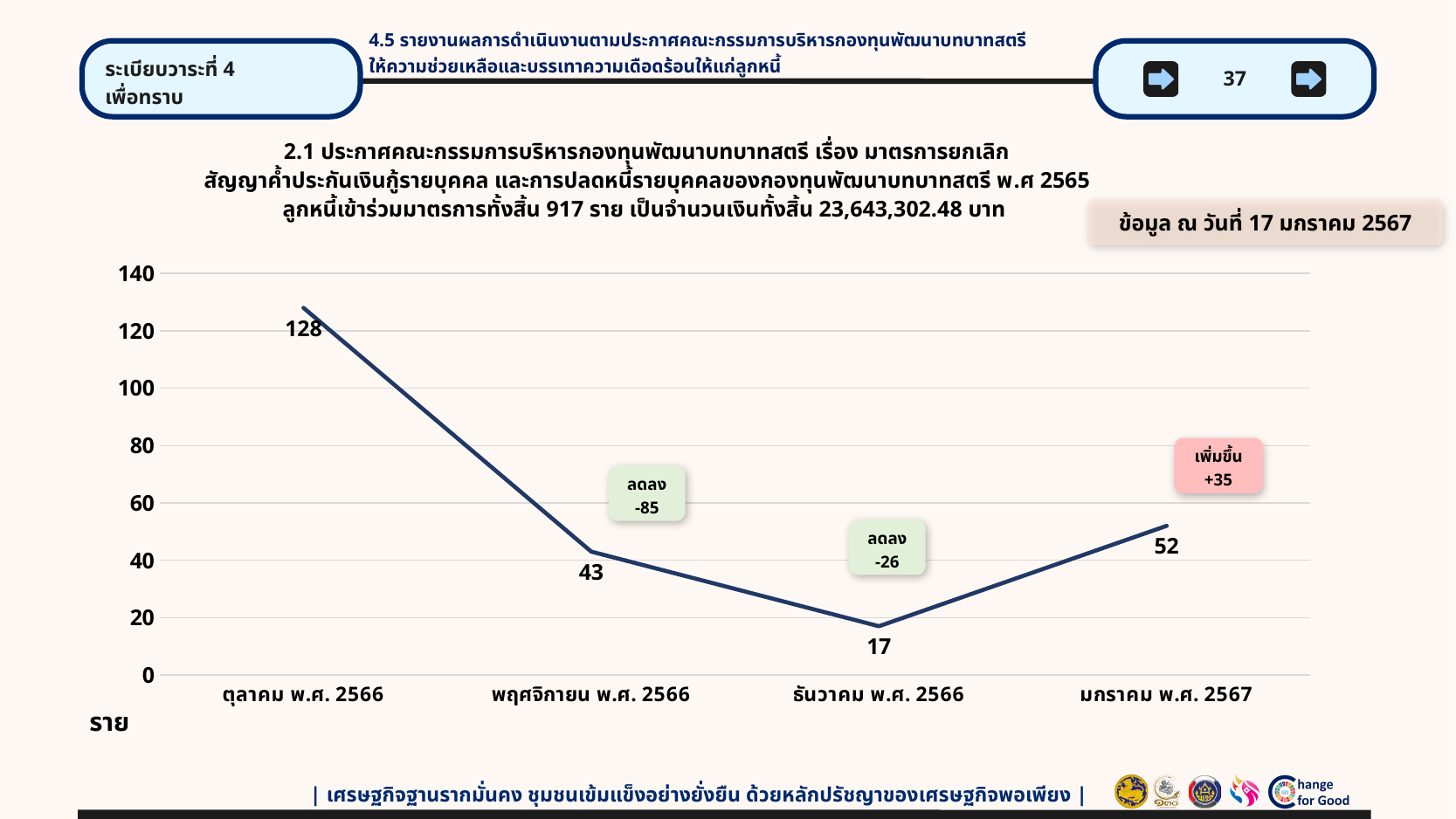
Which month has the highest value? ตุลาคม พ.ศ. 2566 What is the difference between the values for มกราคม พ.ศ. 2567 and ธันวาคม พ.ศ. 2566? 35 How many months are plotted on the chart? 4 What is the value for ธันวาคม พ.ศ. 2566? 17 Which month has the lowest value? ธันวาคม พ.ศ. 2566 Is the value for ตุลาคม พ.ศ. 2566 greater or less than 100? greater What is the value for ตุลาคม พ.ศ. 2566? 128 Which is larger, the value for พฤศจิกายน พ.ศ. 2566 or the value for มกราคม พ.ศ. 2567? มกราคม พ.ศ. 2567 What is the difference between the values for ตุลาคม พ.ศ. 2566 and พฤศจิกายน พ.ศ. 2566? 85 What kind of chart is shown on the slide? line chart What change is shown in the annotation between ธันวาคม พ.ศ. 2566 and มกราคม พ.ศ. 2567? เพิ่มขึ้น +35 What is the value for มกราคม พ.ศ. 2567? 52